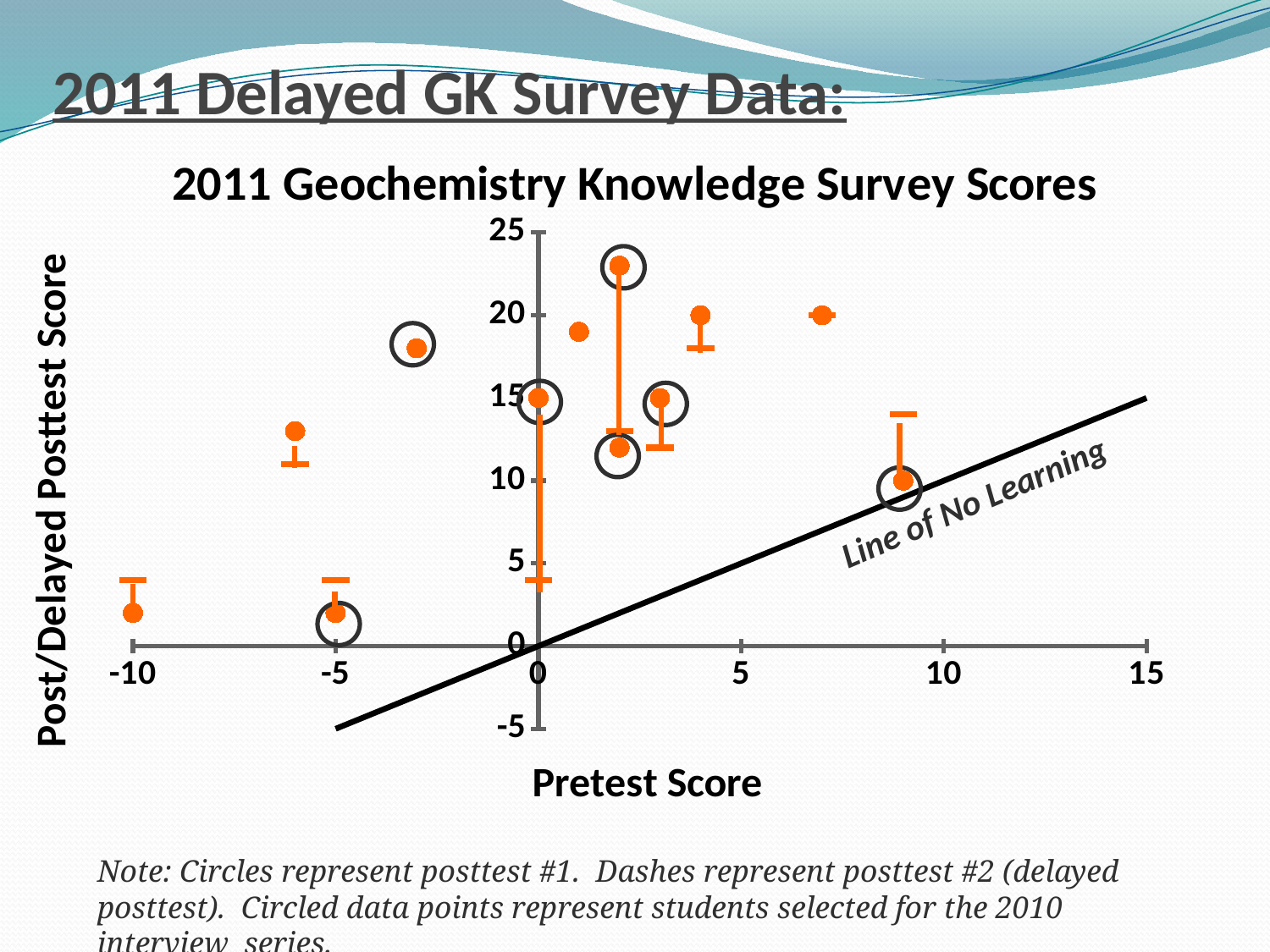
What is the lowest pretest score plotted on the chart? -10 Is the posttest score for the point with a pretest score of -10 greater or less than 5? less Is the posttest score for the point with a pretest score of 9 greater or less than 15? less Is the posttest score for the point with a pretest score of 7 greater or less than 15? greater Which has the higher posttest #1 score: the point at pretest score 7 or the point at pretest score 9? pretest score 7 What is the highest value shown on the y axis? 25 Which pretest score has the highest posttest #1 score (circle) on the chart? 2 What kind of chart is shown on the slide? scatter chart What is the label of the x axis? Pretest Score What is the title of the chart? 2011 Geochemistry Knowledge Survey Scores How many posttest #1 data points (circles) are plotted on the chart? 12